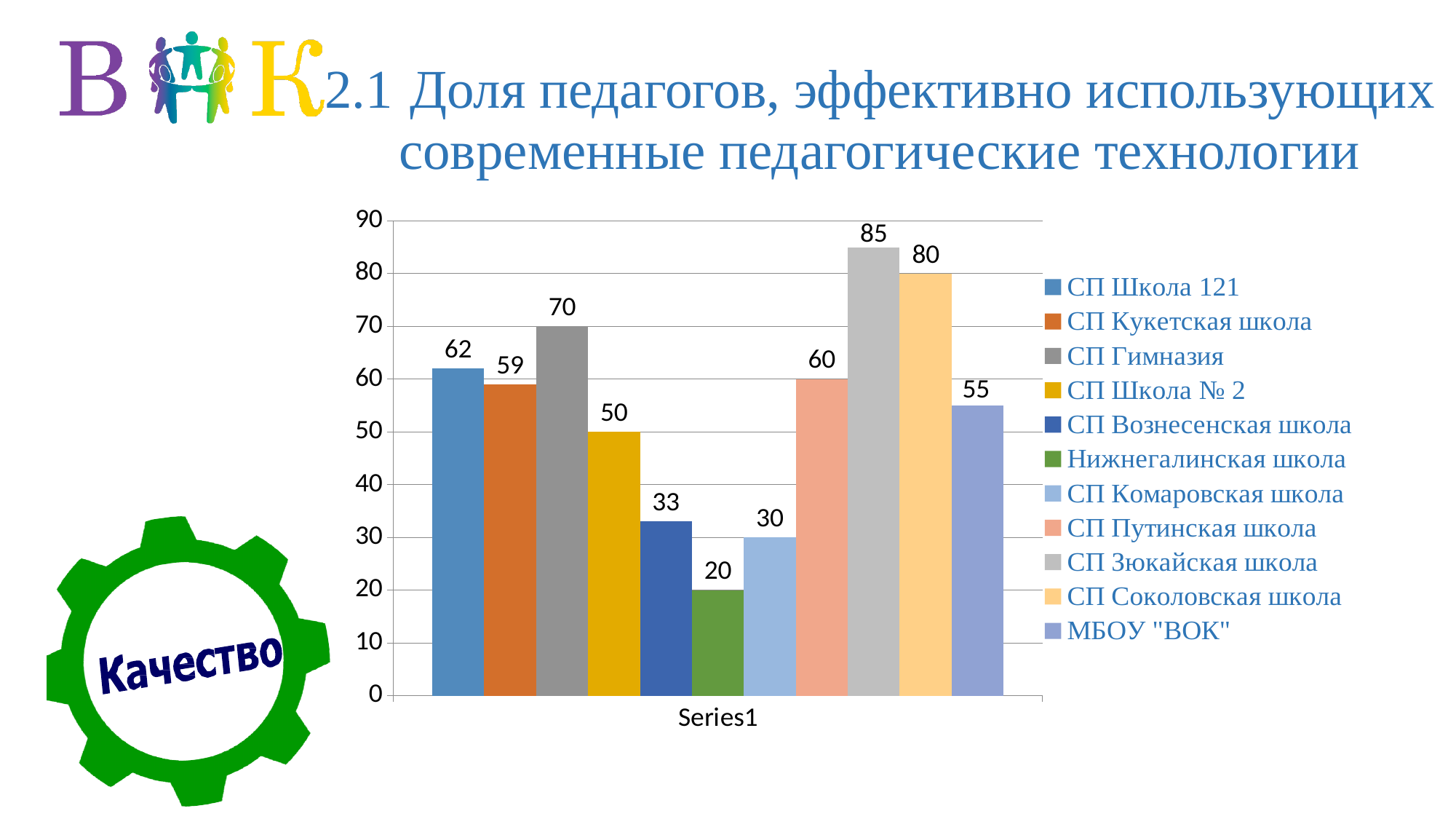
Which school has the lowest value? Нижнегалинская школа What is the difference between the values for СП Вознесенская школа and СП Комаровская школа? 3 What is the value for Нижнегалинская школа? 20 What is the value for СП Зюкайская школа? 85 What is the value for СП Школа 121? 62 Which is larger, the value for СП Гимназия or the value for СП Путинская школа? СП Гимназия What is the difference between the values for СП Зюкайская школа and СП Соколовская школа? 5 Which school has the highest value? СП Зюкайская школа How many series does the legend list? 11 What is the label on the x axis under the bars? Series1 What is the value for МБОУ "ВОК"? 55 What type of chart is shown on the slide? bar chart